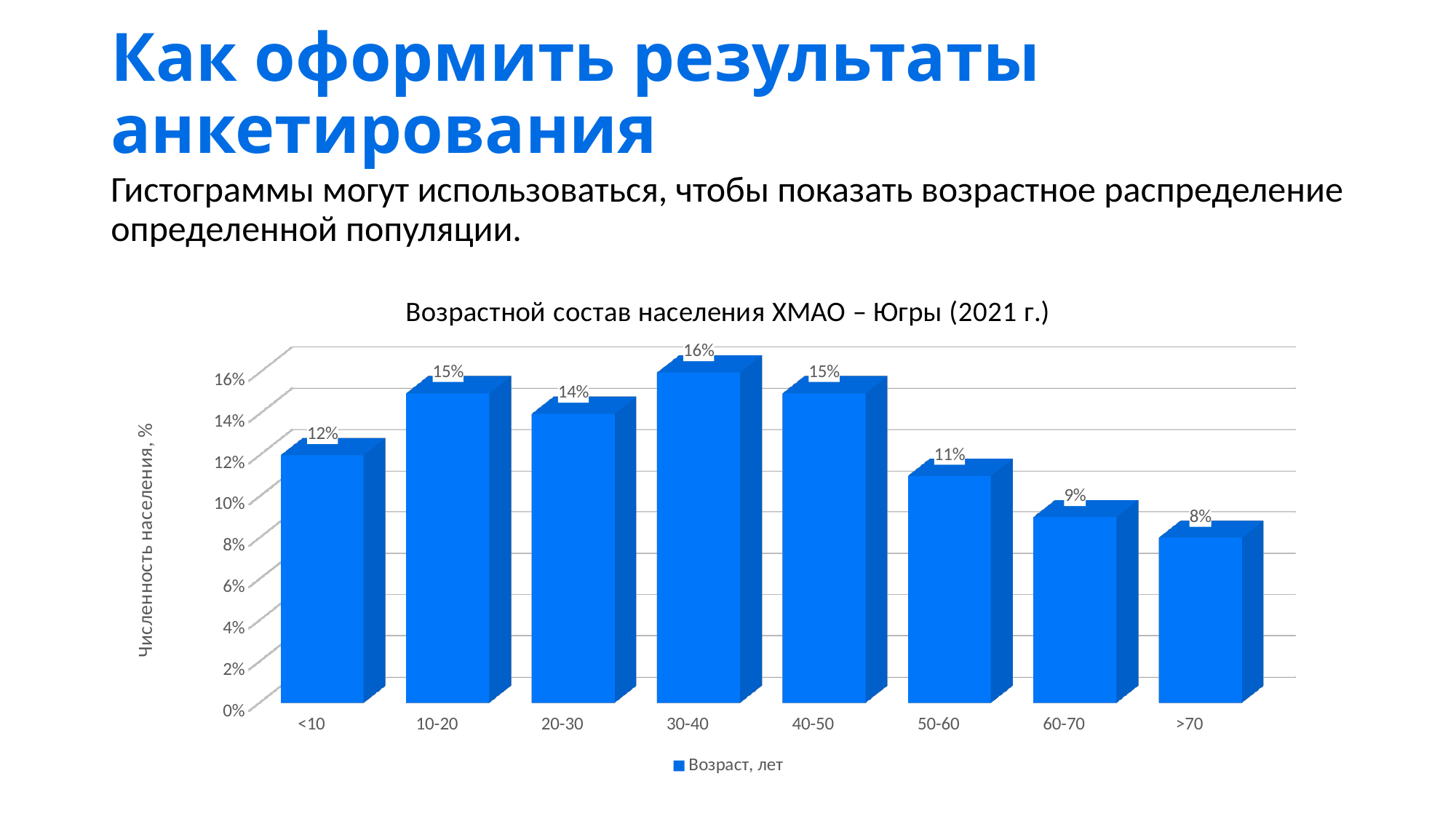
How many age groups are shown on the x axis? 8 Is the value for 50-60 greater or less than 10%? greater Which age group has the highest value? 30-40 Which is larger, the value for 20-30 or the value for 50-60? 20-30 How many series does the legend list? 1 What kind of chart is shown on the slide? Bar chart What is the title of the chart? Возрастной состав населения ХМАО – Югры (2021 г.) What is the value for the 30-40 age group? 16% What is the difference between the values for 30-40 and 60-70? 7% What is the value for the <10 age group? 12% Which age group has the lowest value? >70 What is the value for the >70 age group? 8%